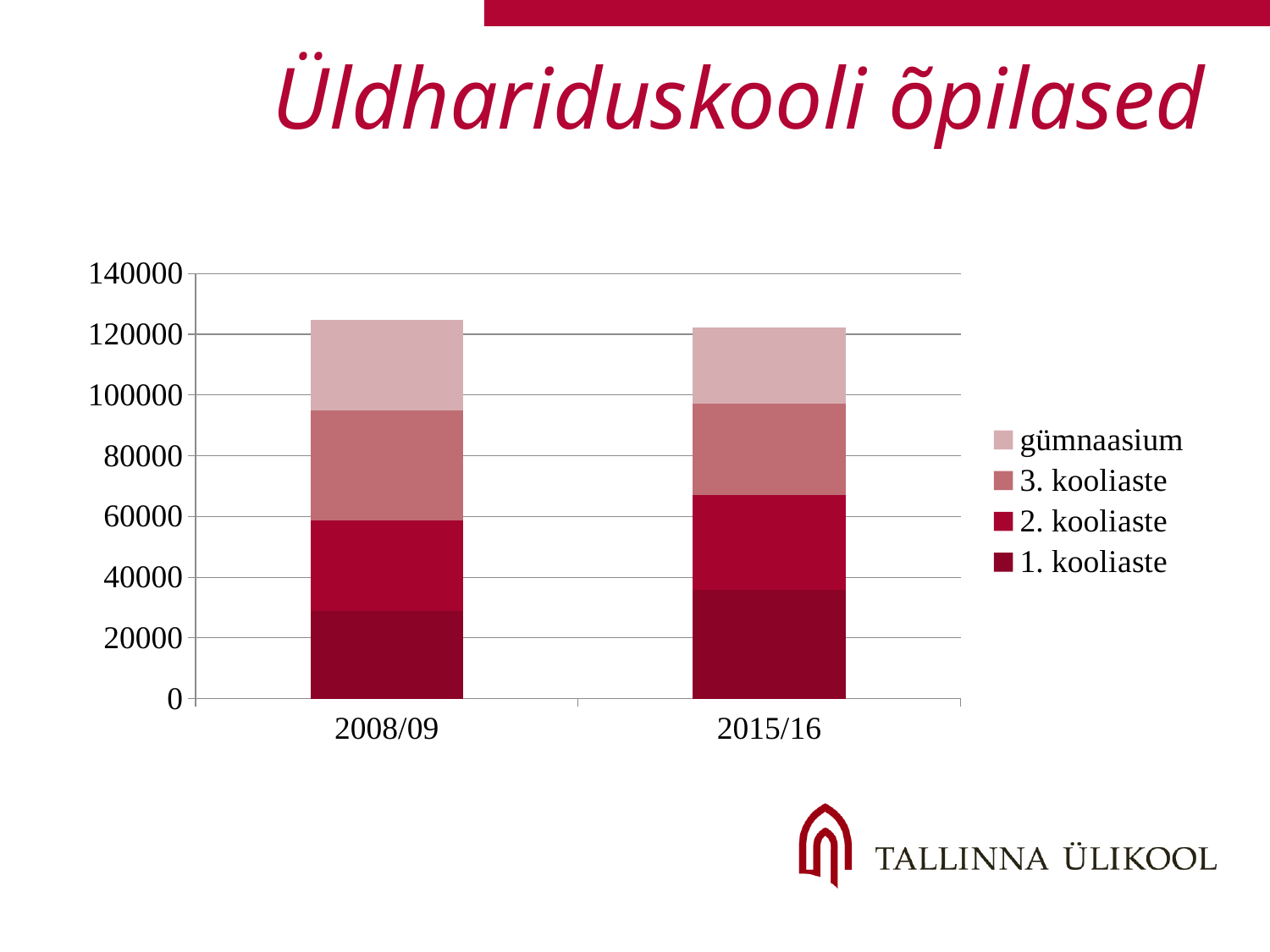
Which year has the larger value for 1. kooliaste, 2008/09 or 2015/16? 2015/16 Which series is shown at the bottom of each stacked bar? 1. kooliaste Is the value for 1. kooliaste in 2008/09 greater or less than 40000? less Which year has the larger value for gümnaasium, 2008/09 or 2015/16? 2008/09 What is the title of the slide containing the chart? Üldhariduskooli õpilased Is the value for 1. kooliaste in 2015/16 greater or less than 20000? greater Is the total height of the 2015/16 stacked bar greater or less than 100000? greater How many series does the legend list? 4 How many school years (categories) are shown on the x axis? 2 What kind of chart is shown on the slide? stacked bar chart